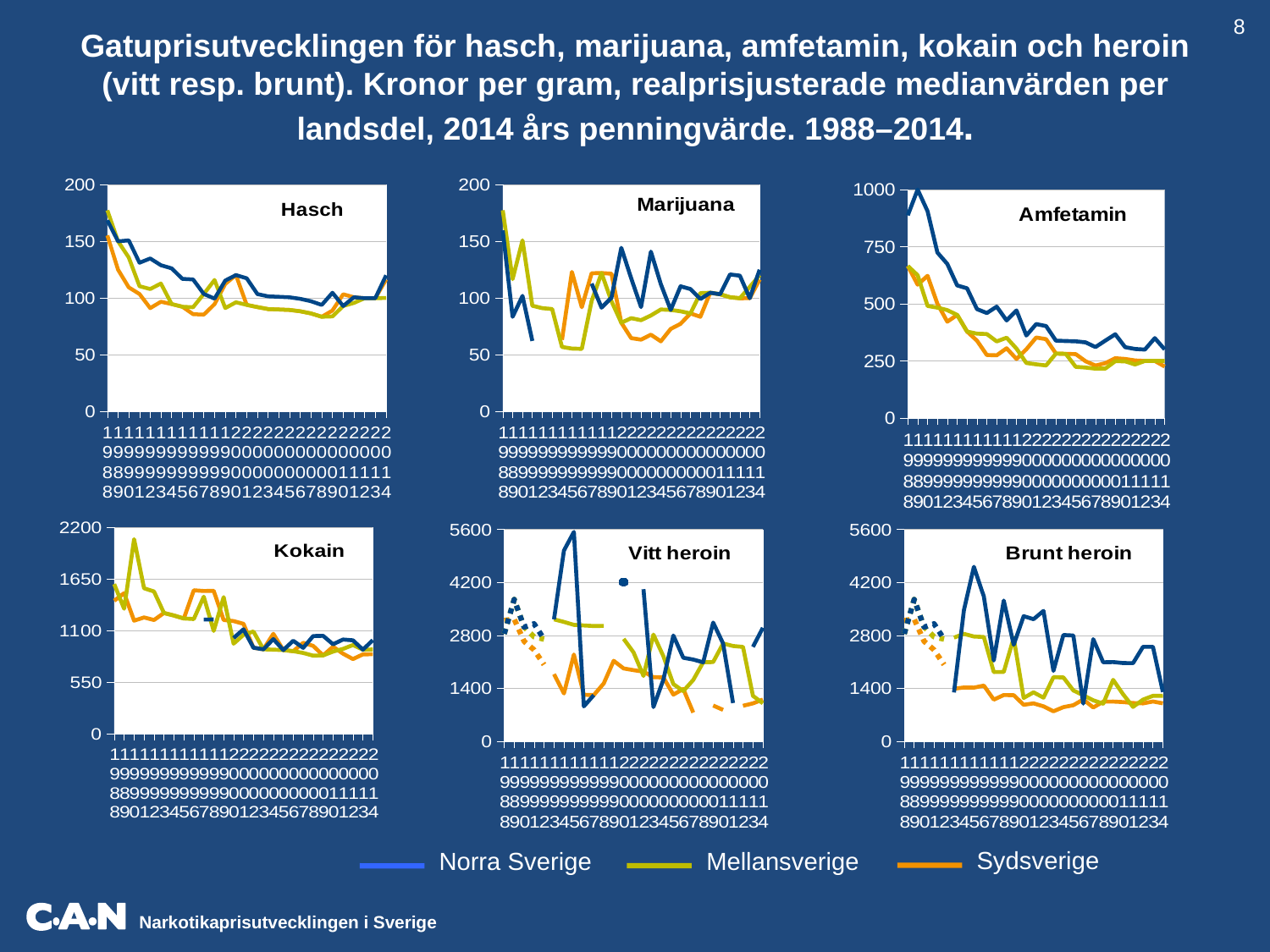
In the Kokain chart, is the highest Mellansverige value greater or less than 1650? greater In the Hasch chart, is the Norra Sverige value in 1988 greater or less than 150? greater In the Amfetamin chart, which series is highest in 2014? Norra Sverige Which series does the legend show in orange? Sydsverige In the Amfetamin chart, does the Norra Sverige line generally rise or fall from 1988 to 2014? fall In the Amfetamin chart, is the Norra Sverige value in 2014 greater or less than 250? greater How many separate charts are shown on the slide? 6 What is the title of the chart in the top-right position? Amfetamin In the Amfetamin chart, which series has the higher value in 1988, Norra Sverige or Sydsverige? Norra Sverige What kind of chart is used for the Hasch panel? line chart How many series does the legend at the bottom of the slide list? 3